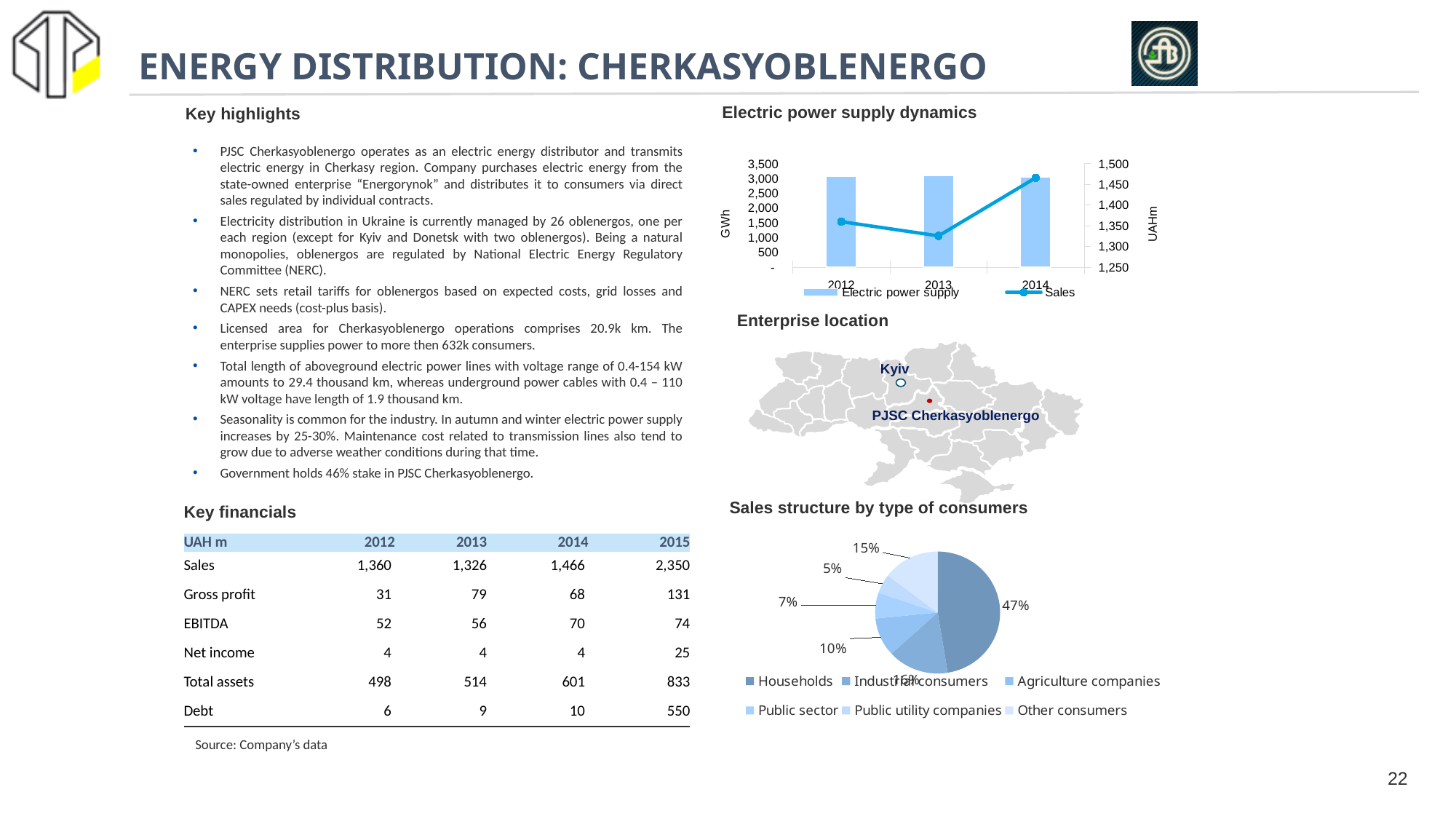
How many years are shown on the x axis of the 'Electric power supply dynamics' chart? 3 What kind of chart is the 'Electric power supply dynamics' chart? A combination bar and line chart How many series does the legend of the 'Electric power supply dynamics' chart list? 2 In the 'Electric power supply dynamics' chart, is the Electric power supply value for 2013 greater or less than 2,500 GWh? greater In the 'Sales structure by type of consumers' pie chart, which type of consumer has the largest share? Households In the 'Electric power supply dynamics' chart, is the Sales value for 2013 greater or less than 1,400 UAHm? less In the 'Sales structure by type of consumers' pie chart, how many consumer types are shown? 6 In the 'Sales structure by type of consumers' pie chart, which type of consumer has the smallest share? Public utility companies In the 'Electric power supply dynamics' chart, which year has the highest Sales value? 2014 In the 'Sales structure by type of consumers' pie chart, what is the difference in percentage points between Households and Industrial consumers? 31 percentage points In the 'Electric power supply dynamics' chart, is the Sales value for 2014 greater or less than 1,400 UAHm? greater In the 'Sales structure by type of consumers' pie chart, what share do Households account for? 47%